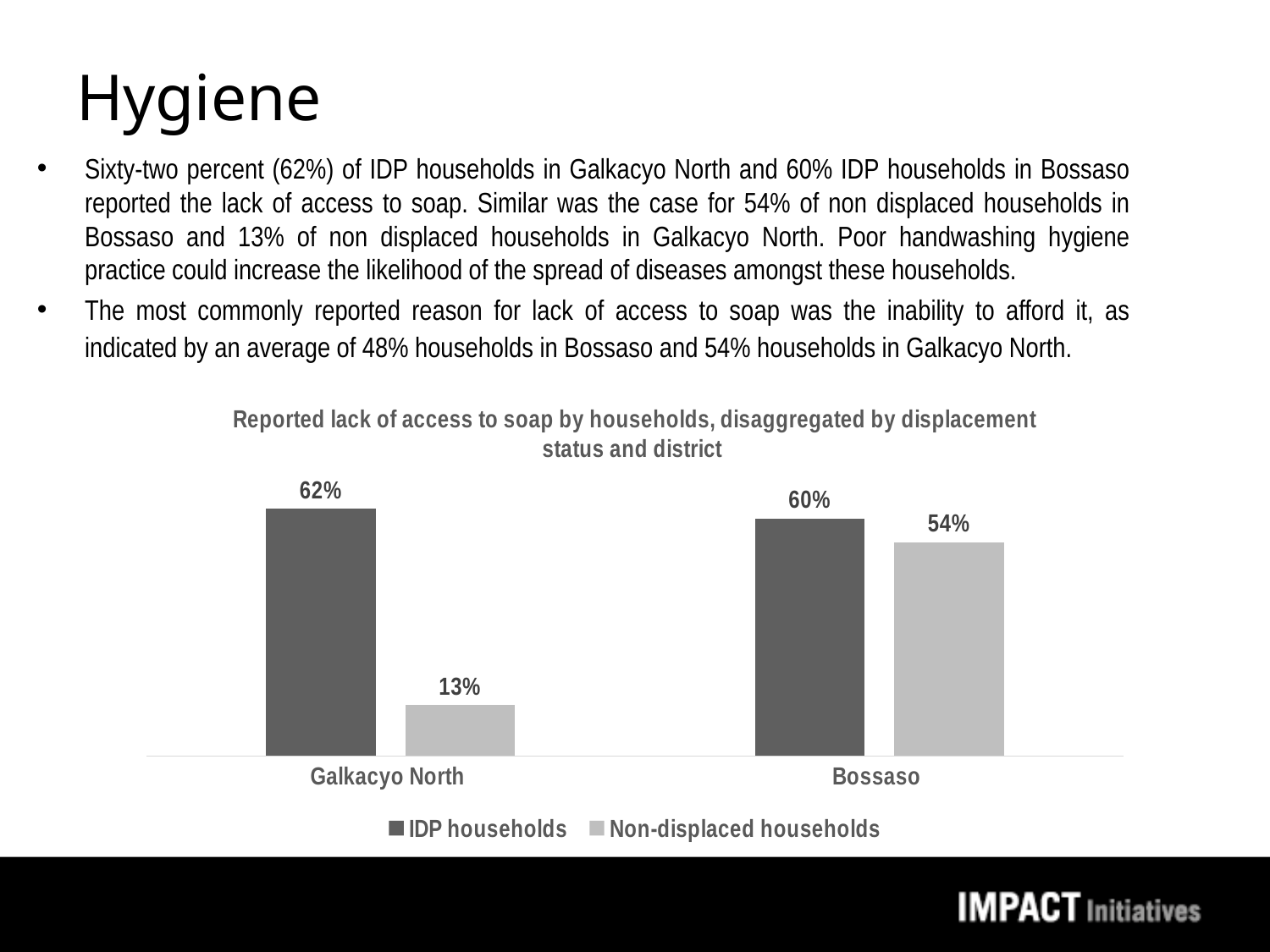
What is the value for IDP households in Bossaso? 60% What is the value for Non-displaced households in Bossaso? 54% Which bar shows the highest value on the chart? IDP households in Galkacyo North What type of chart is shown on the slide? Bar chart What percentage of IDP households in Galkacyo North reported lack of access to soap? 62% What is the value for Non-displaced households in Galkacyo North? 13% How many series does the legend list? 2 Which is larger: Non-displaced households in Bossaso or Non-displaced households in Galkacyo North? Non-displaced households in Bossaso What is the difference between IDP households and Non-displaced households in Bossaso? 6% How many districts are shown on the x axis? 2 What is the difference between IDP households and Non-displaced households in Galkacyo North? 49% Which bar shows the lowest value on the chart? Non-displaced households in Galkacyo North